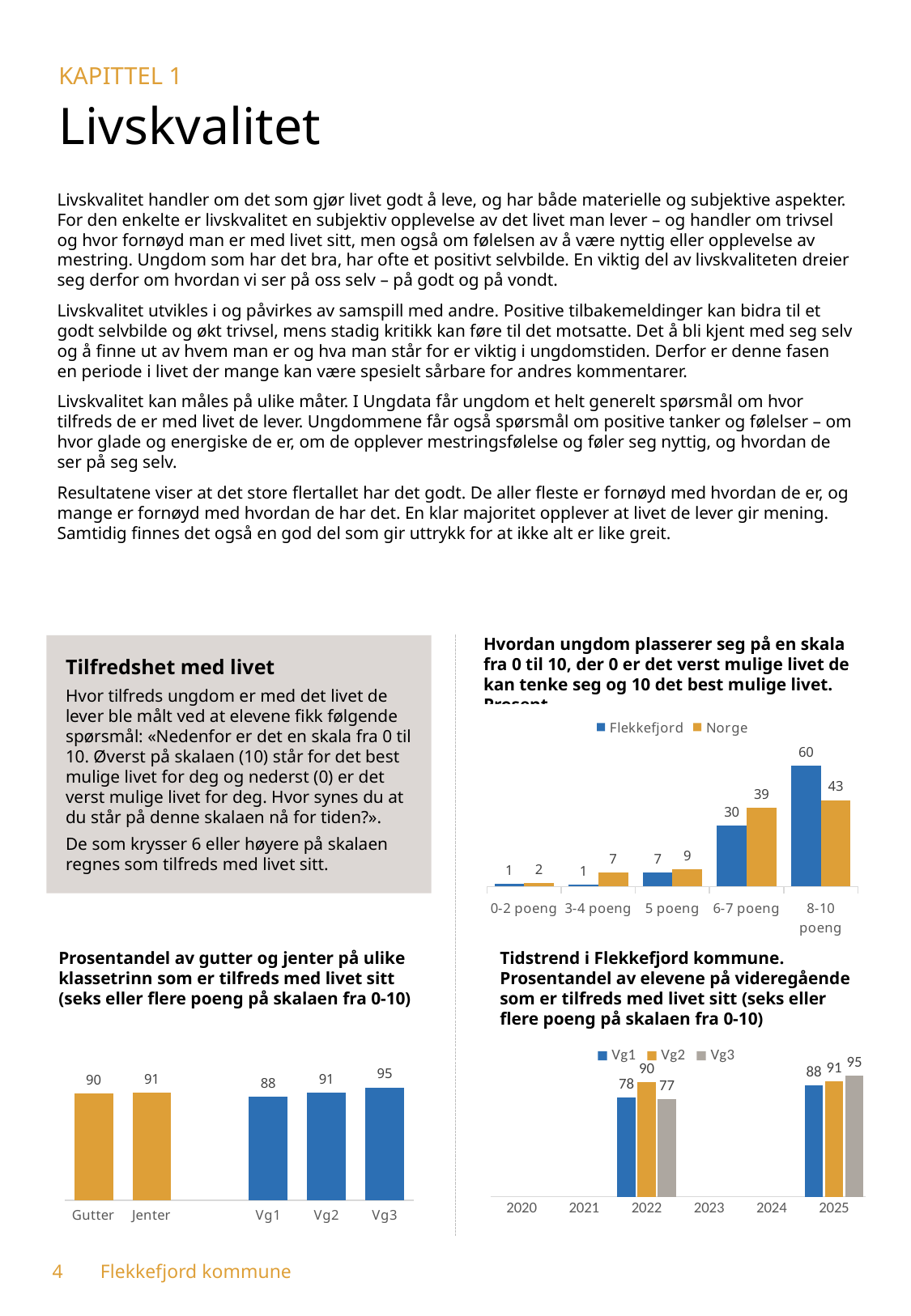
In the chart 'Hvordan ungdom plasserer seg på en skala fra 0 til 10', how many series does the legend list? 2 In the chart 'Hvordan ungdom plasserer seg på en skala fra 0 til 10', is the value for Norge in the 3-4 poeng category larger or smaller than the value for Flekkefjord in that category? larger In the chart 'Hvordan ungdom plasserer seg på en skala fra 0 til 10', what is the value for Norge in the 6-7 poeng category? 39 In the chart 'Prosentandel av gutter og jenter på ulike klassetrinn som er tilfreds med livet sitt', which category has the lowest value? Vg1 In the chart 'Prosentandel av gutter og jenter på ulike klassetrinn som er tilfreds med livet sitt', how many categories are shown on the x axis? 5 What kind of chart is 'Tidstrend i Flekkefjord kommune'? bar chart In the chart 'Hvordan ungdom plasserer seg på en skala fra 0 til 10', which category has the highest value for Flekkefjord? 8-10 poeng In the chart 'Prosentandel av gutter og jenter på ulike klassetrinn som er tilfreds med livet sitt', what is the value for Vg3? 95 In the chart 'Tidstrend i Flekkefjord kommune', what is the difference between the Vg3 values for 2025 and 2022? 18 In the chart 'Hvordan ungdom plasserer seg på en skala fra 0 til 10', what is the difference between Flekkefjord and Norge in the 8-10 poeng category? 17 In the chart 'Tidstrend i Flekkefjord kommune', what is the value for Vg2 in 2022? 90 In the chart 'Hvordan ungdom plasserer seg på en skala fra 0 til 10', what is the value for Flekkefjord in the 8-10 poeng category? 60